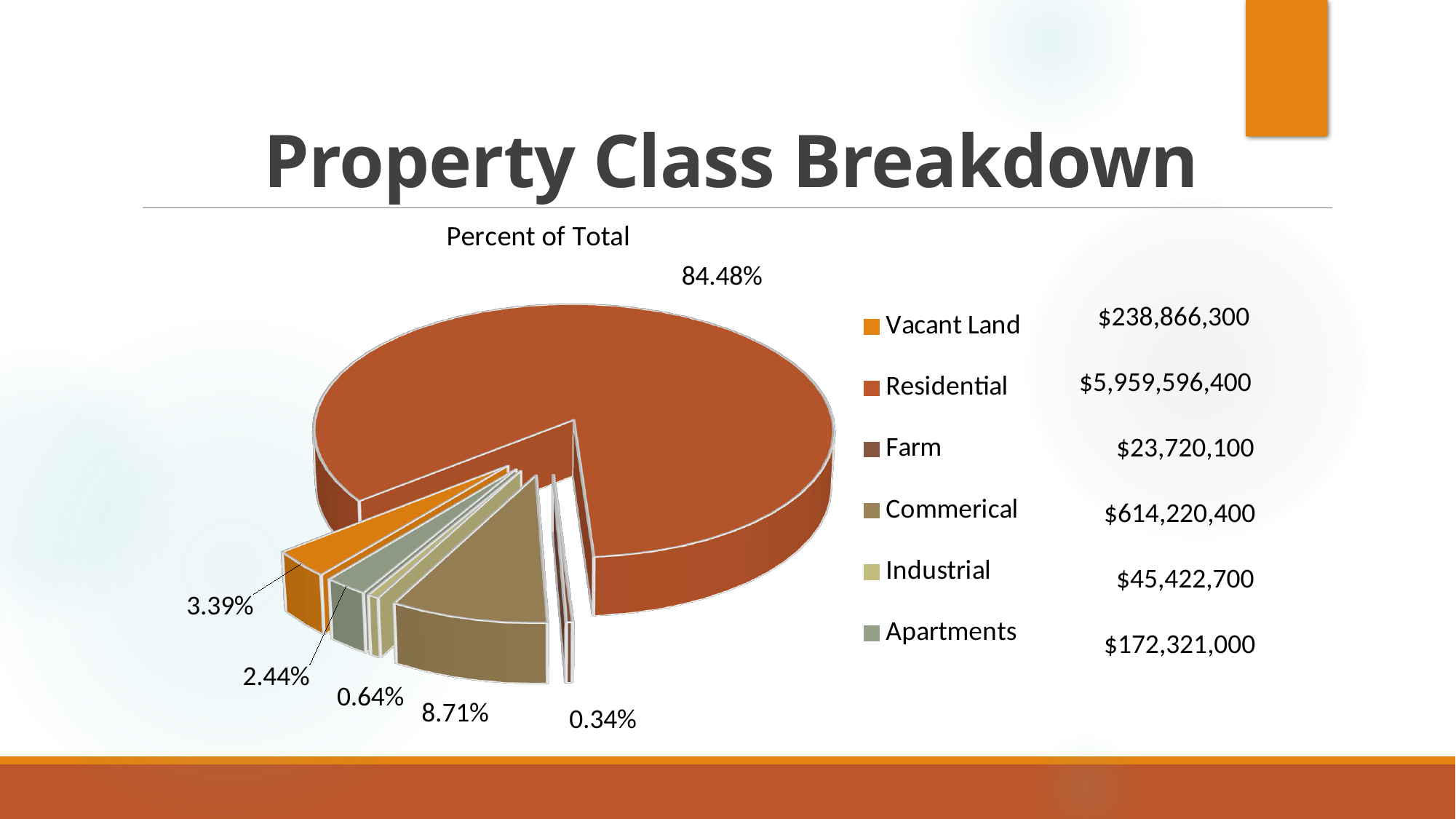
Which property class has the smallest share of the pie? Farm What is the difference in percentage points between the Commerical and Vacant Land slices? 5.32% What kind of chart is shown on the slide? pie chart What percentage of the total does the Vacant Land slice represent? 3.39% What is the title of the chart? Percent of Total What percentage of the total does the Residential slice represent? 84.48% Which property class has the largest share of the pie? Residential What percentage of the total does the Farm slice represent? 0.34% How many categories does the legend of the pie chart list? 6 Which has a larger share of the pie, Vacant Land or Apartments? Vacant Land What percentage of the total does the Commerical slice represent? 8.71% What percentage of the total does the Apartments slice represent? 2.44%